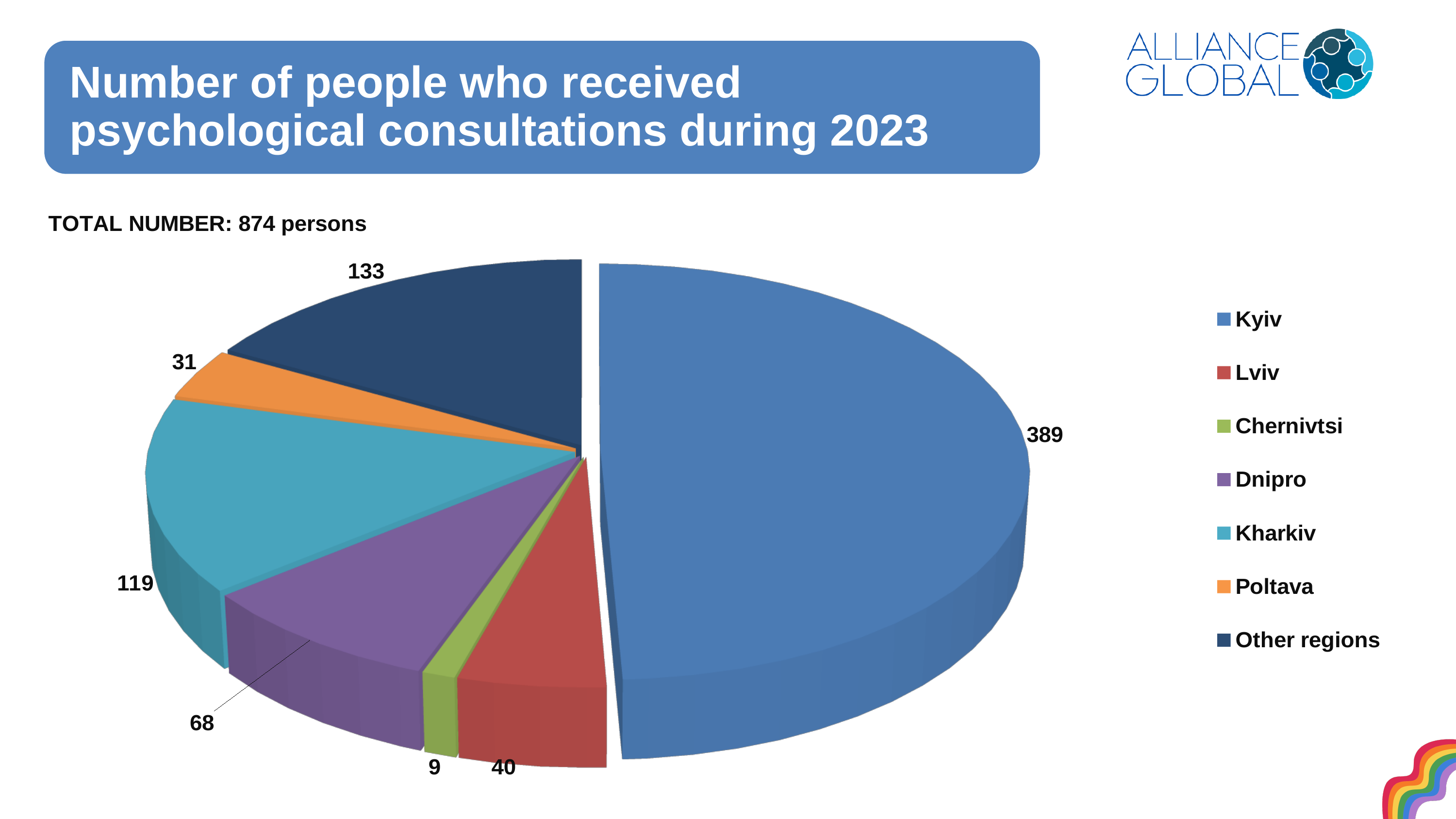
How many regions are listed in the legend? 7 What total number of persons is stated on the slide? 874 persons What is the difference between the values for Kyiv and Other regions? 256 How many people received psychological consultations in Kyiv? 389 What is the value for Other regions? 133 What is the value for Chernivtsi? 9 What is the value for Kharkiv? 119 Which region has the smallest slice of the pie? Chernivtsi What kind of chart is shown on the slide? pie chart Which region has the largest slice of the pie? Kyiv What is the difference between the values for Dnipro and Poltava? 37 Which is larger, the value for Lviv or the value for Kharkiv? Kharkiv